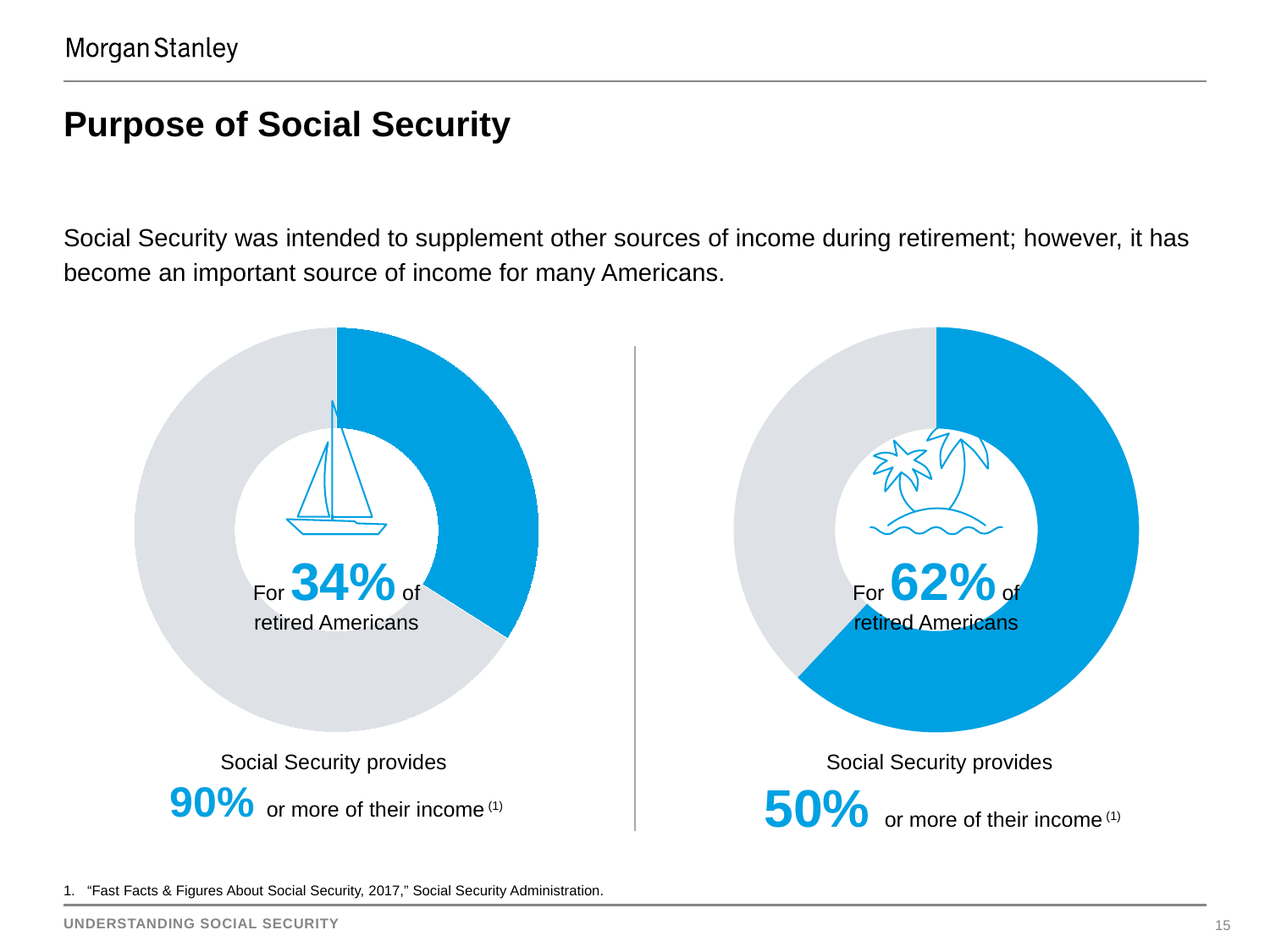
In the right donut chart, is the blue slice more or less than half of the ring? More Which donut chart has the larger blue slice, the left one or the right one? The right one How many donut charts are on the slide? 2 What kind of chart is shown on the left side of the slide? Donut (pie) chart According to the text under the right donut chart, Social Security provides what share or more of income for the 62% of retired Americans? 50% In the left donut chart, is the blue slice more or less than half of the ring? Less In the left donut chart, what percentage of retired Americans does the blue slice represent? 34% According to the text under the left donut chart, Social Security provides what share or more of income for the 34% of retired Americans? 90% What is the title of the slide containing the two donut charts? Purpose of Social Security What colour is used for the highlighted slice in both donut charts? Blue What is the difference in percentage points between the blue slice of the right donut chart (62%) and the blue slice of the left donut chart (34%)? 28 percentage points In the right donut chart, what percentage of retired Americans does the blue slice represent? 62%